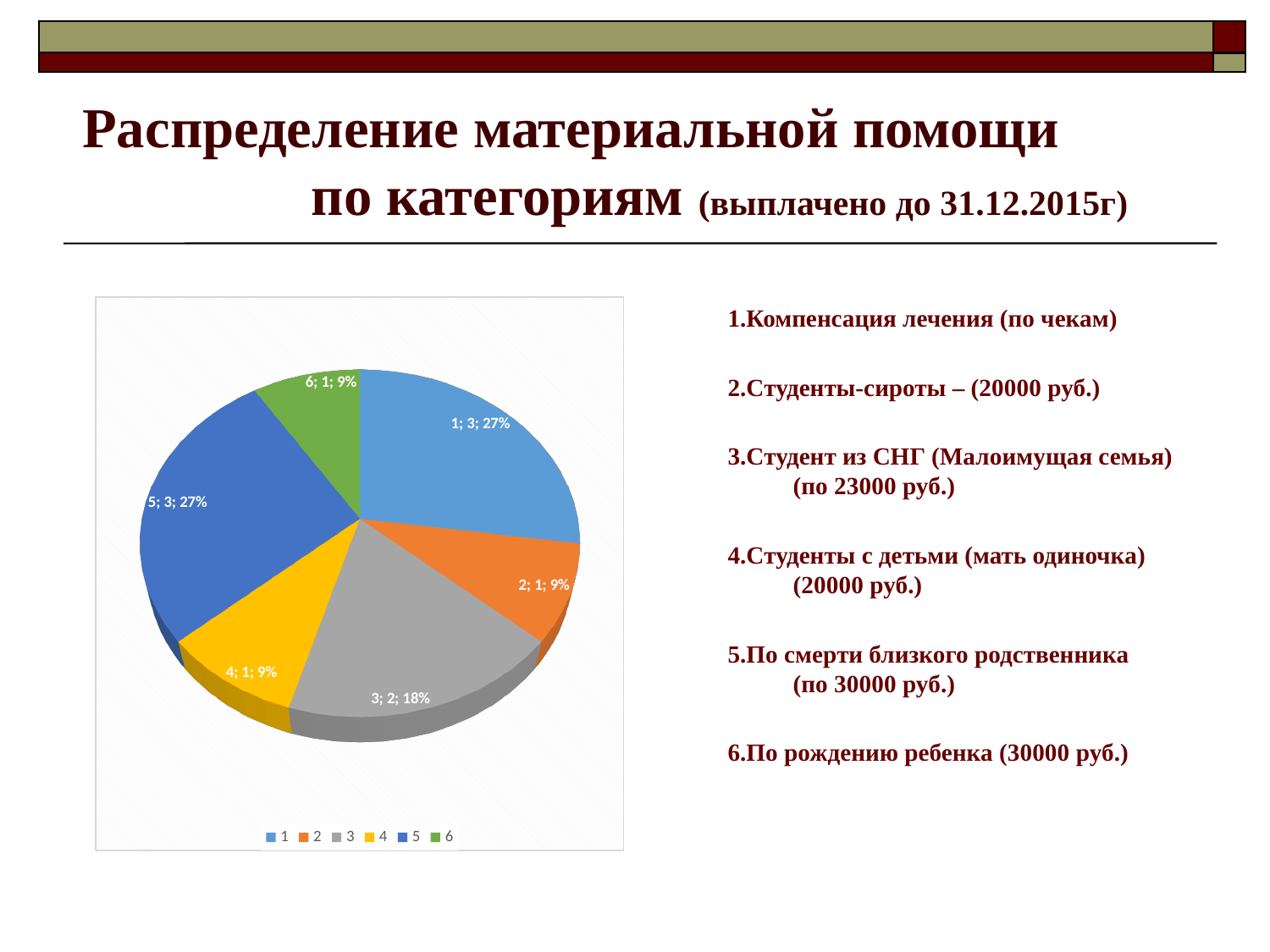
What value is shown for category 3 in the pie chart? 2 Which has the larger value, category 3 or category 4? category 3 What share of the pie does category 6 represent? 9% What value is shown for category 1 in the pie chart? 3 What kind of chart is shown on the slide? pie chart What is the total of all the values shown in the pie chart? 11 How many categories (slices) does the pie chart have? 6 What share of the pie does category 3 represent? 18% What value is shown for category 5 in the pie chart? 3 What is the difference between the values for category 1 and category 2? 2 What share of the pie does category 1 represent? 27% How many entries does the legend of the pie chart list? 6